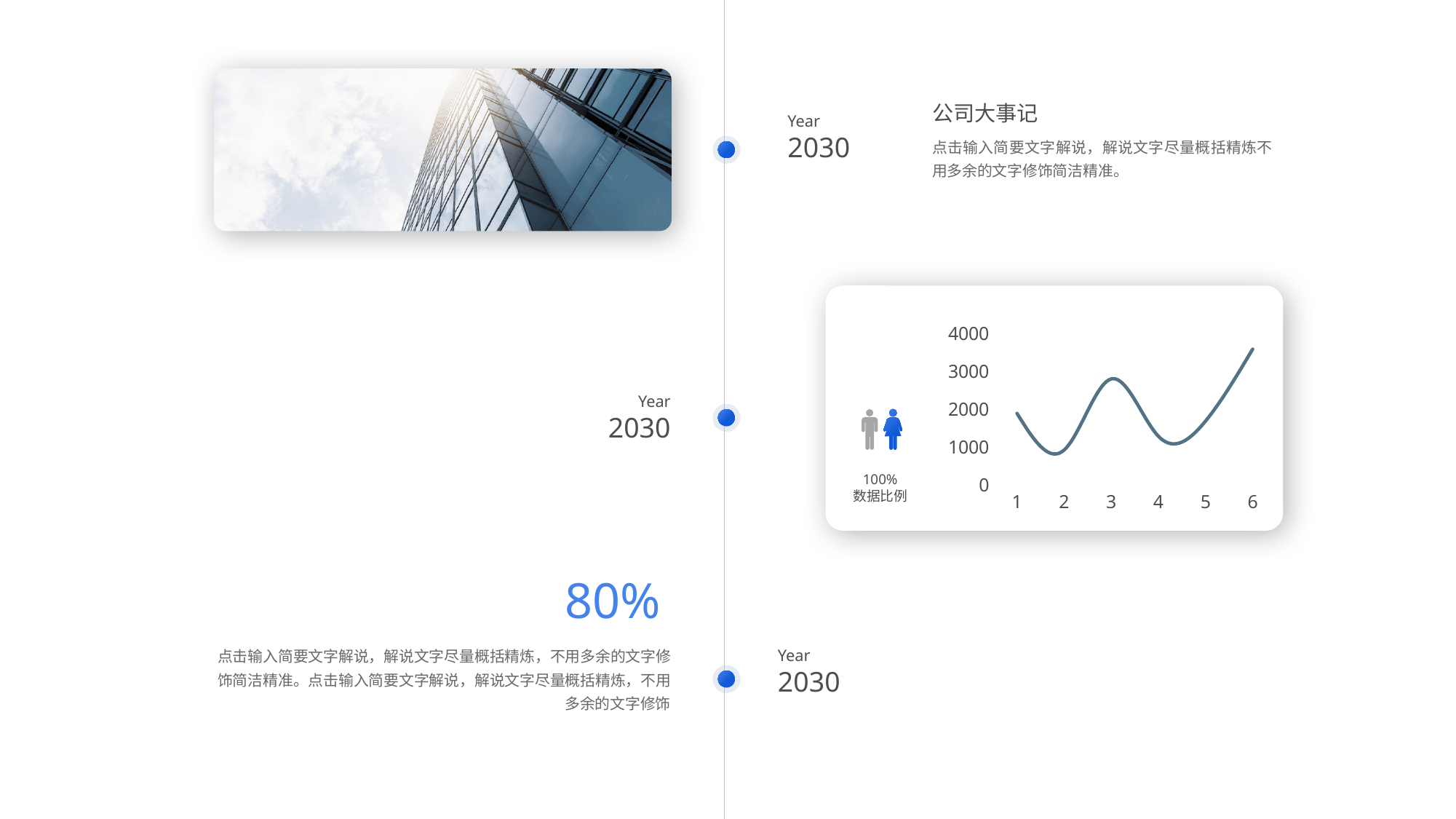
Which is larger, the value at x = 3 or the value at x = 6? 6 Which is larger, the value at x = 1 or the value at x = 2? 1 Is the value at x = 6 greater or less than 3000? greater Does the line rise steadily, fall steadily, or fluctuate up and down from x = 1 to x = 6? fluctuate up and down At which x-axis category does the line chart reach its highest value? 6 Is the value at x = 1 greater or less than 1000? greater What kind of chart is shown on the slide? line chart At which x-axis category does the line chart reach its lowest value? 2 How many points are plotted along the x axis of the line chart? 6 What is the highest value labelled on the y axis of the line chart? 4000 Is the value at x = 4 greater or less than 2000? less